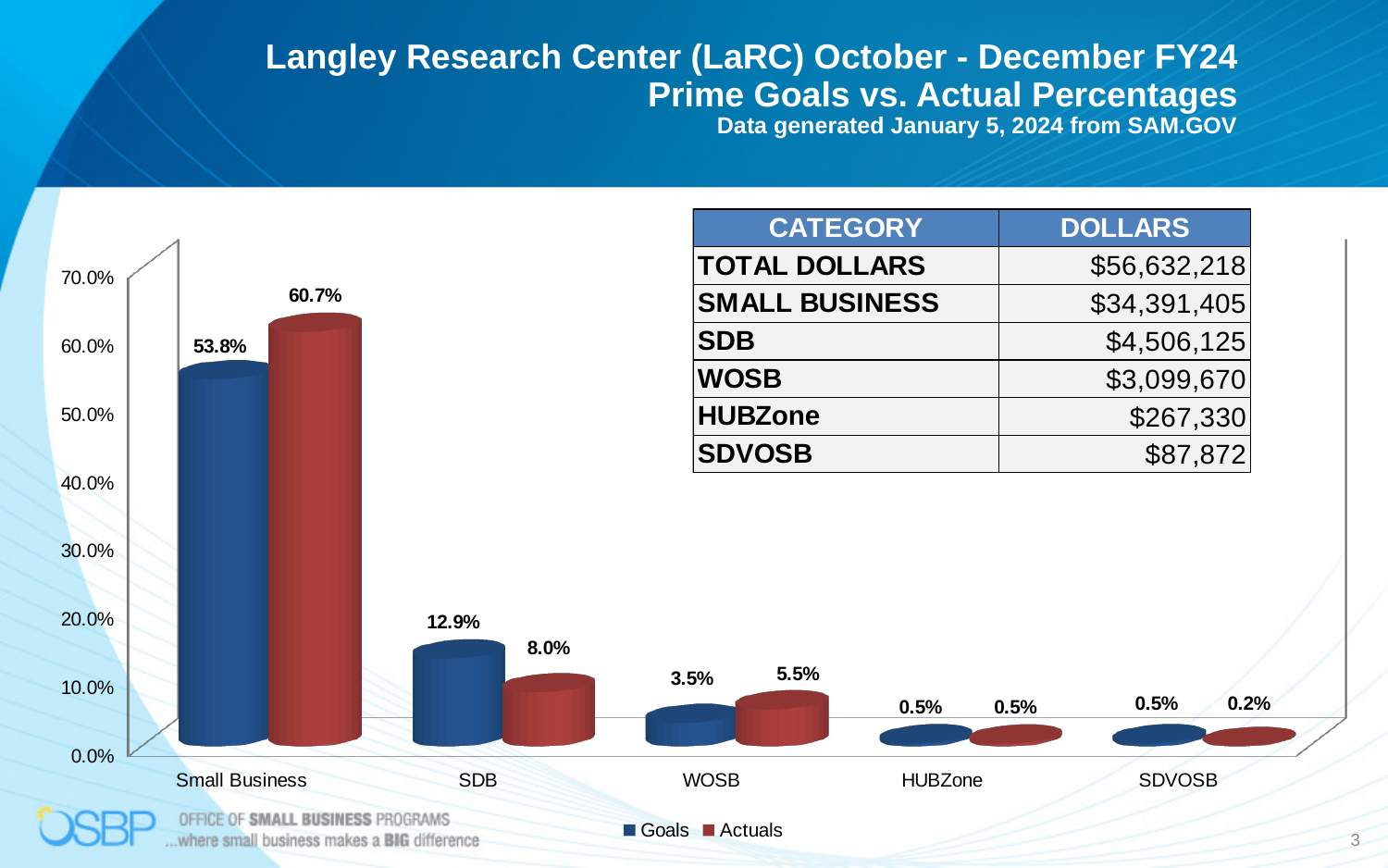
Which category has the lowest Actuals value? SDVOSB How many series does the legend list? 2 Which category has the highest Actuals value? Small Business Which colour represents the Actuals series in the chart? Red What is the Actuals value for SDB? 8.0% What is the difference between the Actuals and Goals values for Small Business? 6.9% Which is larger for SDB, the Goals value or the Actuals value? Goals What is the Goals value for Small Business? 53.8% What is the Goals value for SDVOSB? 0.5% How many categories are shown on the x axis? 5 What is the Actuals value for WOSB? 5.5% What kind of chart is shown on the slide? Bar chart